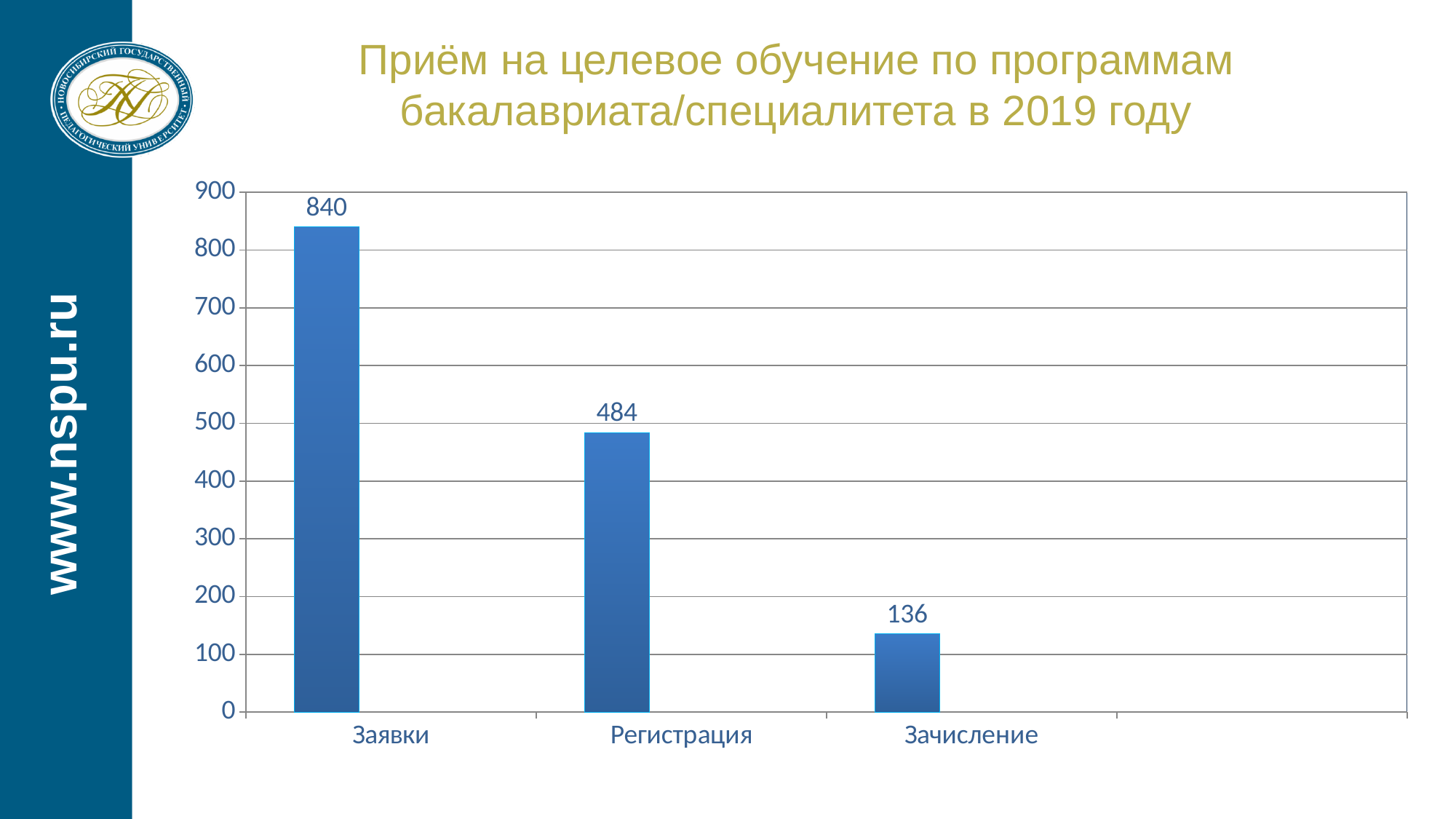
Do the values rise or fall from left to right along the x axis? fall What kind of chart is shown on the slide? bar chart What is the difference between the values for Регистрация and Зачисление? 348 Which is larger, the value for Регистрация or the value for Зачисление? Регистрация Is the value for Регистрация greater or less than 500? less What is the value for Регистрация? 484 What is the difference between the values for Заявки and Регистрация? 356 What is the value for Заявки? 840 How many categories are shown on the x axis? 3 Which category has the lowest value? Зачисление What is the value for Зачисление? 136 Which category has the highest value? Заявки